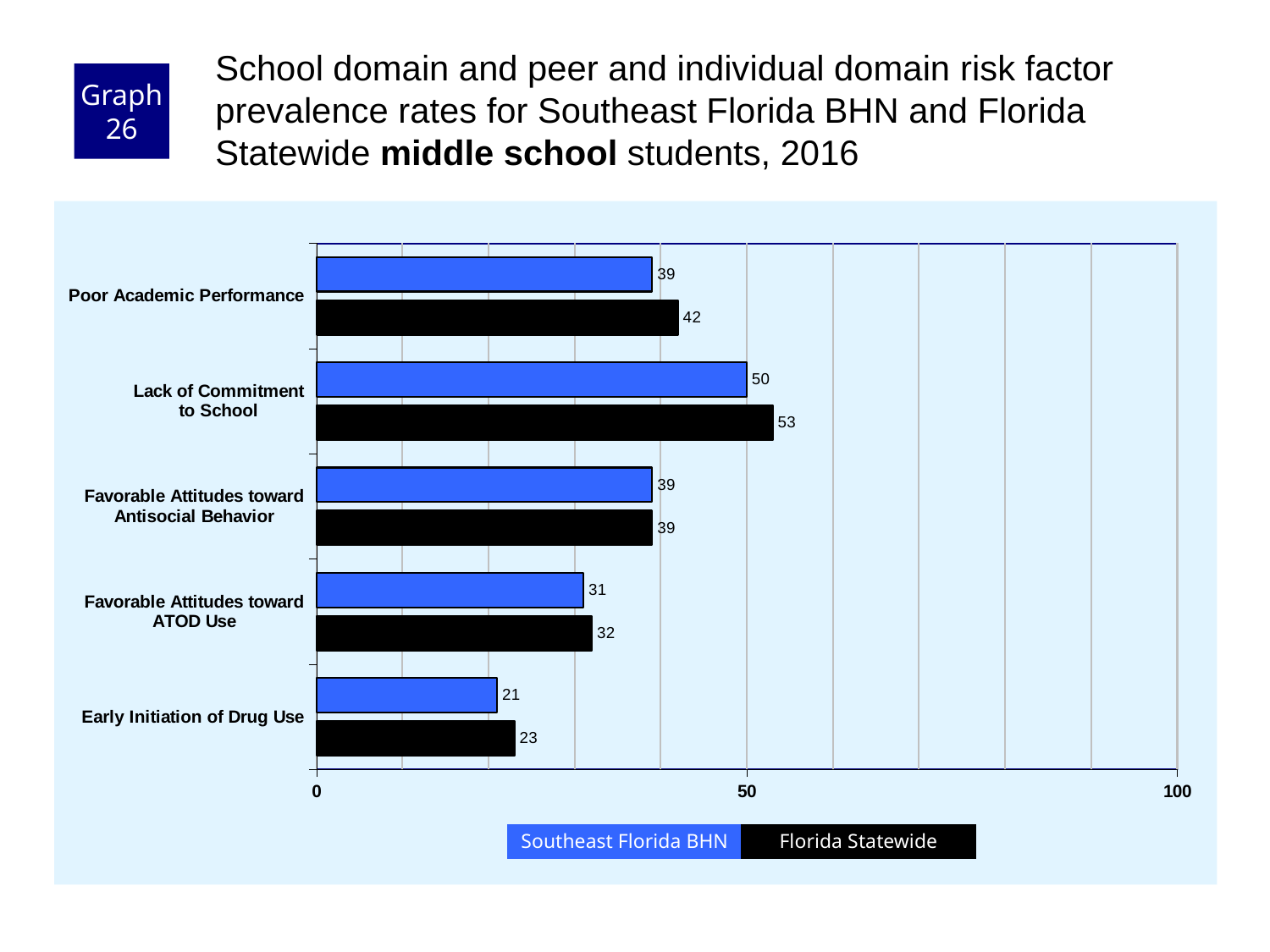
Which is larger for Lack of Commitment to School: the Southeast Florida BHN value or the Florida Statewide value? Florida Statewide How many risk factor categories are shown on the chart? 5 What kind of chart is shown on the slide? bar chart Which risk factor has the highest Florida Statewide value? Lack of Commitment to School What is the Southeast Florida BHN value for Poor Academic Performance? 39 What is the difference between the Florida Statewide and Southeast Florida BHN values for Poor Academic Performance? 3 Is the Florida Statewide value for Early Initiation of Drug Use greater or less than 50? less Which risk factor has the lowest Southeast Florida BHN value? Early Initiation of Drug Use What is the Southeast Florida BHN value for Early Initiation of Drug Use? 21 How many series does the legend list? 2 What is the Florida Statewide value for Favorable Attitudes toward ATOD Use? 32 What is the Florida Statewide value for Lack of Commitment to School? 53